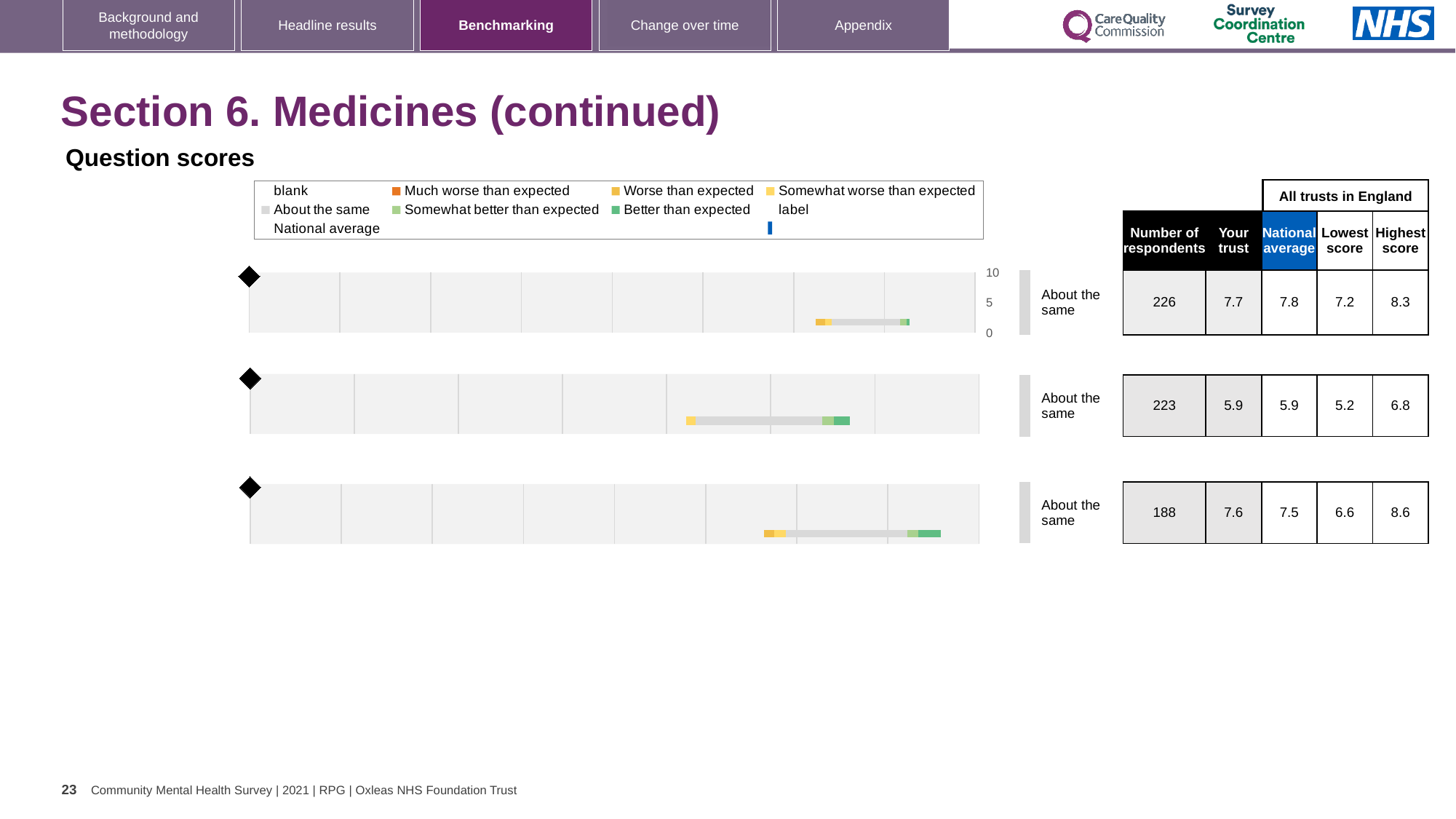
In the table next to the charts, what is the highest score for the third (bottom) row? 8.6 In the table next to the charts, what is the 'Your trust' score for the first (top) row? 7.7 In the table next to the charts, what is the lowest score for the first (top) row? 7.2 For the third (bottom) row, is the 'Your trust' score larger or smaller than the national average? Larger Which of the three rows in the table has the highest 'Your trust' score? The first (top) row, 7.7 What is the difference between the highest score and the lowest score for the second (middle) row in the table? 1.6 How many benchmarking charts (rows) are shown on the slide? 3 Which of the three rows in the table has the lowest number of respondents? The third (bottom) row, 188 In the table next to the charts, how many respondents are listed for the third (bottom) row? 188 What kind of chart is used for the benchmarking rows on the slide? Bar chart In the table next to the charts, what is the national average for the second (middle) row? 5.9 What is the maximum value shown on the vertical axis scale next to the top chart? 10